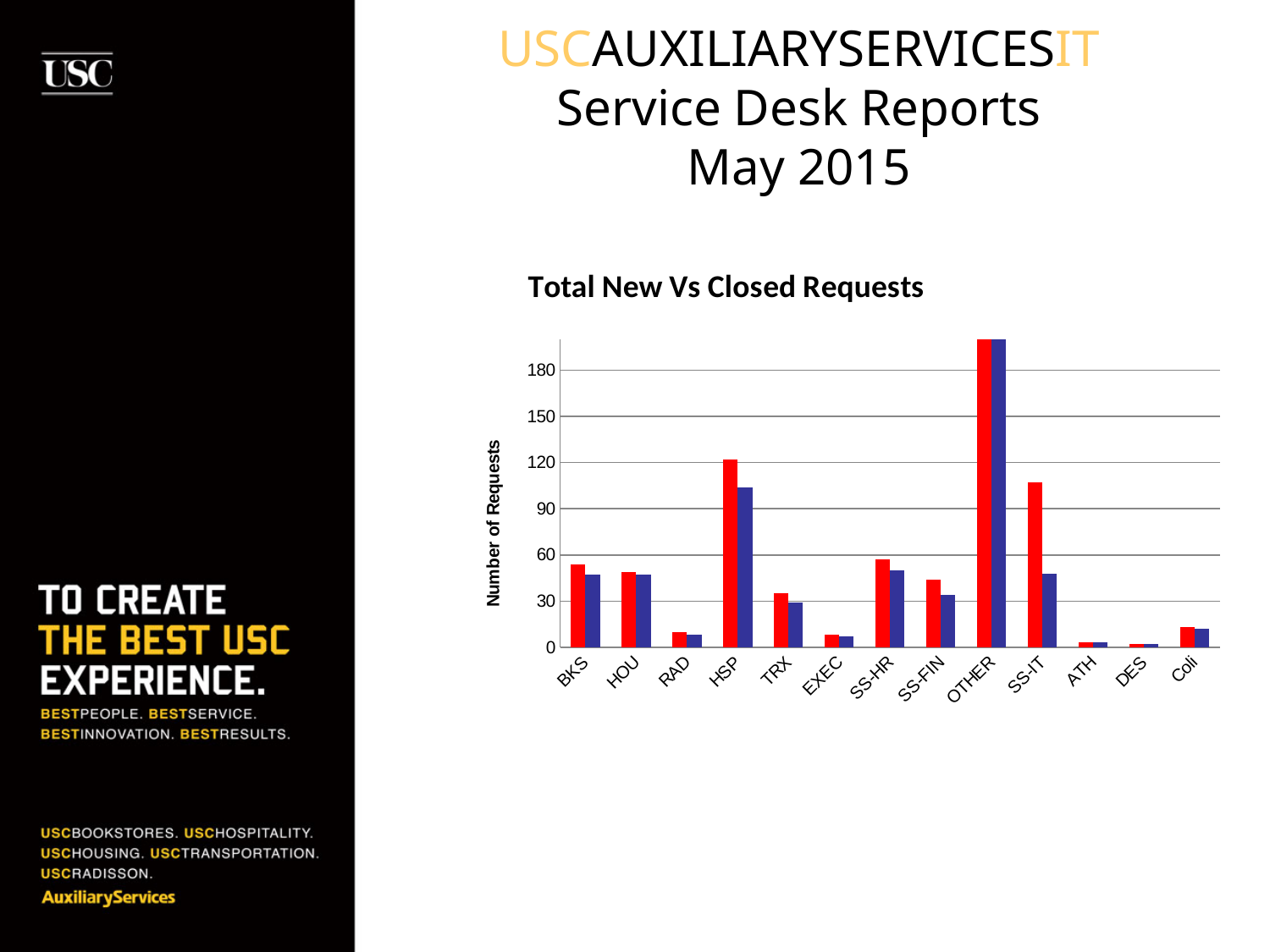
Is the value of the red bar for HSP greater or less than 90? greater Is the value of the red bar for SS-IT greater or less than 120? less Which category has the highest number of requests? OTHER What is the label on the vertical axis of the chart? Number of Requests How many categories are shown along the x axis of the chart? 13 Which category has a higher red bar, HSP or SS-IT? HSP Is the value of the red bar for OTHER greater or less than 180? greater Which category has the lowest number of requests? DES Which category has a higher red bar, TRX or SS-HR? SS-HR What is the title of the chart? Total New Vs Closed Requests What kind of chart is shown on the slide? bar chart